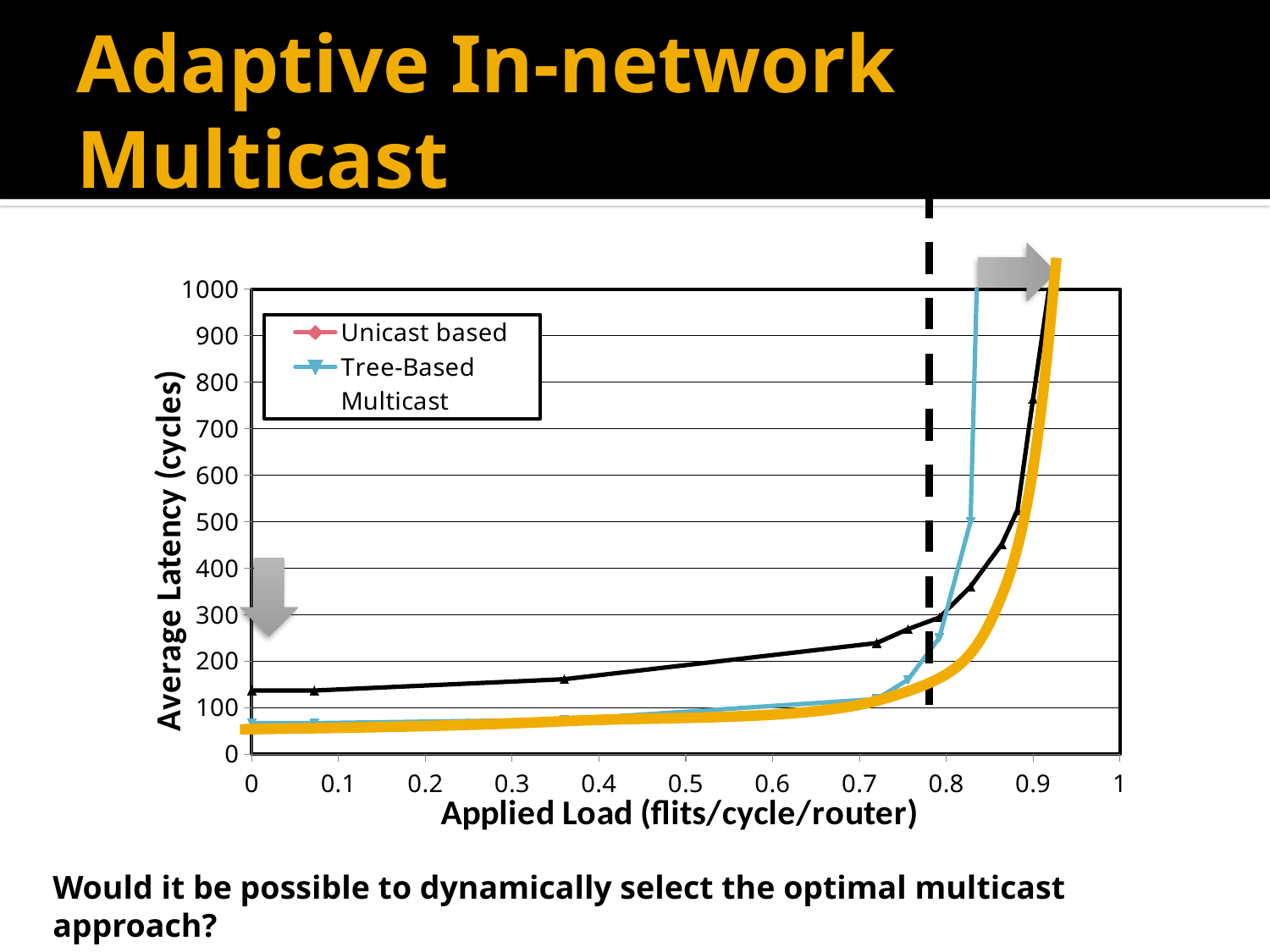
At an applied load of 0.9, is the value for Unicast based greater or less than 700? greater Does the average latency rise or fall as the applied load increases along the x axis? rise What is the label of the x axis? Applied Load (flits/cycle/router) At an applied load of 0, is the value for Unicast based greater or less than 100? greater How many series does the chart legend list? 2 At an applied load of 0, which series has the higher average latency, Unicast based or Tree-Based Multicast? Unicast based At an applied load of 0, is the value for Tree-Based Multicast greater or less than 100? less What is the label of the y axis? Average Latency (cycles) What kind of chart is shown on the slide? line chart At an applied load of about 0.4, which series has the lower average latency, Unicast based or Tree-Based Multicast? Tree-Based Multicast What is the highest value shown on the y axis? 1000